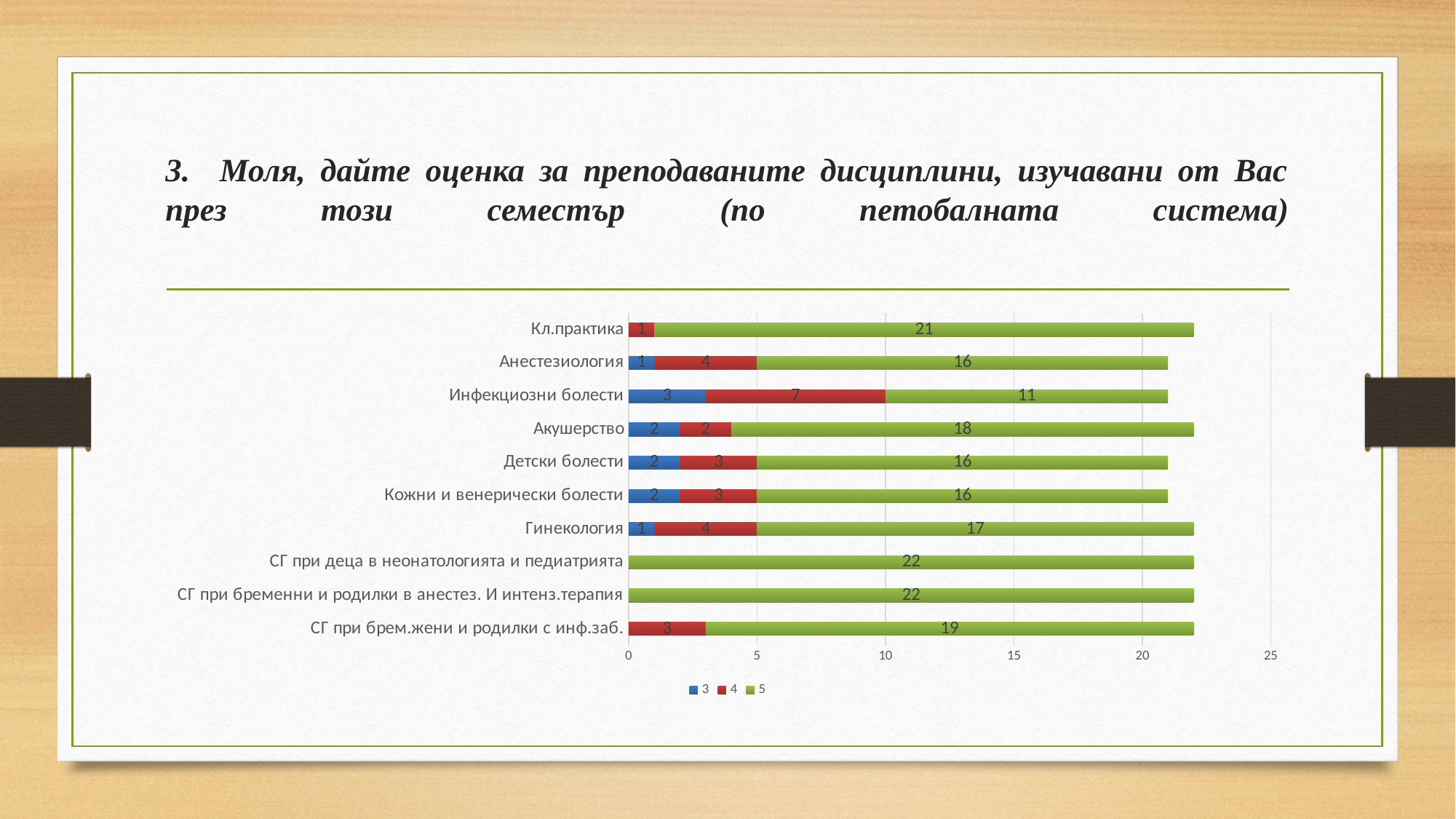
What is the value of series "3" for Акушерство? 2 Which category has the highest value for series "4"? Инфекциозни болести Which is larger: the series "5" value for Анестезиология or for СГ при брем.жени и родилки с инф.заб.? СГ при брем.жени и родилки с инф.заб. How many series does the legend list? 3 What is the total of the stacked bar for Инфекциозни болести? 21 What is the value of series "4" for Инфекциозни болести? 7 What is the value of series "5" for Кл.практика? 21 What are the legend entries of the chart? 3, 4, 5 How many categories are shown on the chart? 10 What is the difference between the series "5" values for Акушерство and Гинекология? 1 Which category has the lowest value for series "5"? Инфекциозни болести What kind of chart is shown on the slide? Stacked bar chart